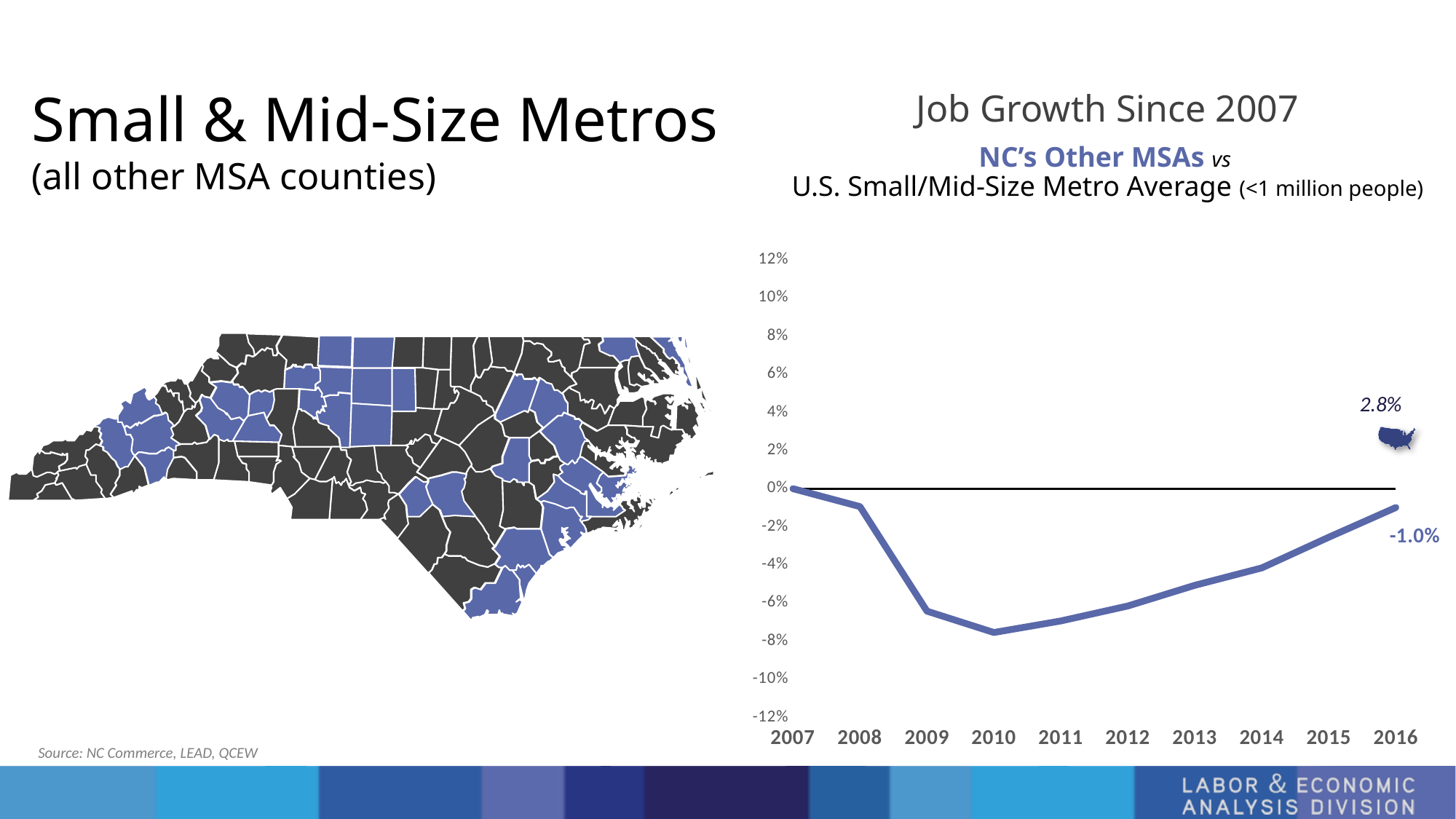
On the Job Growth Since 2007 chart, is the NC's Other MSAs value for 2008 greater or less than -2%? greater On the Job Growth Since 2007 chart, is the NC's Other MSAs value for 2010 greater or less than -6%? less On the Job Growth Since 2007 chart, which is higher in 2016: NC's Other MSAs or the U.S. Small/Mid-Size Metro Average? U.S. Small/Mid-Size Metro Average What kind of chart is the Job Growth Since 2007 chart? line chart What is the source cited at the bottom of the slide? NC Commerce, LEAD, QCEW On the Job Growth Since 2007 chart, is the NC's Other MSAs value for 2013 greater or less than -4%? less How many years are shown on the x axis of the Job Growth Since 2007 chart? 10 What is the 2016 value for NC's Other MSAs on the Job Growth Since 2007 chart? -1.0% In which year does the NC's Other MSAs line reach its lowest point on the Job Growth Since 2007 chart? 2010 On the Job Growth Since 2007 chart, what is the difference between the U.S. Small/Mid-Size Metro Average (2.8%) and NC's Other MSAs (-1.0%) in 2016? 3.8 percentage points On the Job Growth Since 2007 chart, does the NC's Other MSAs line rise or fall from 2010 to 2016? rise What is the 2016 value for the U.S. Small/Mid-Size Metro Average on the Job Growth Since 2007 chart? 2.8%